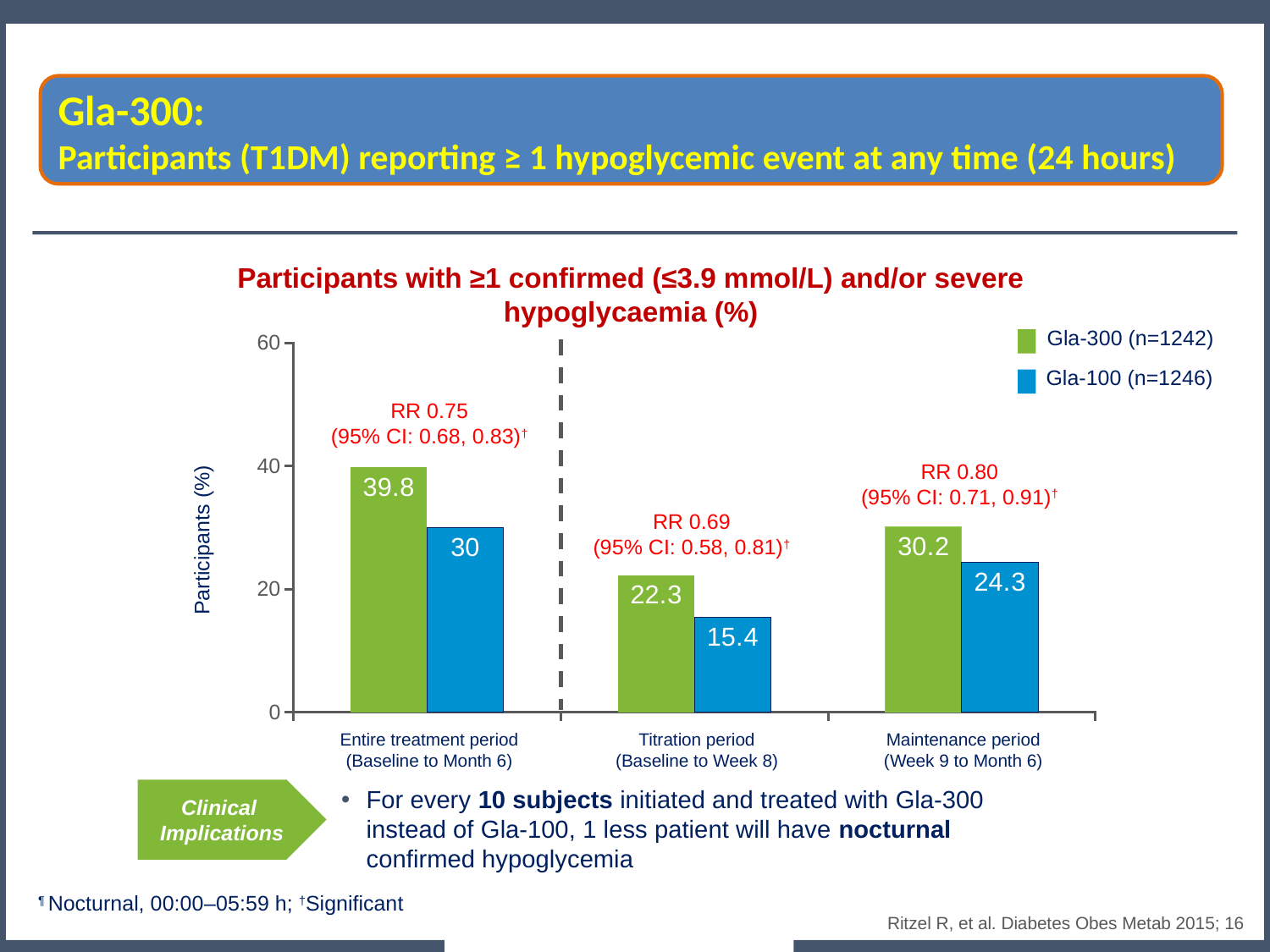
How many series does the legend list? 2 What is the value for Gla-100 in the Maintenance period (Week 9 to Month 6)? 24.3 What is the difference between the Gla-300 and Gla-100 values in the Entire treatment period? 9.8 Which period has the highest value for Gla-300? Entire treatment period (Baseline to Month 6) Is the value for Gla-300 in the Maintenance period greater or less than 40? less Which period has the lowest value for Gla-100? Titration period (Baseline to Week 8) How many periods (categories) are shown on the x axis? 3 What kind of chart is shown on the slide? bar chart In the Maintenance period, which is larger: the Gla-300 value or the Gla-100 value? Gla-300 What is the difference between the Gla-300 and Gla-100 values in the Titration period? 6.9 What is the value for Gla-100 in the Titration period (Baseline to Week 8)? 15.4 What is the value for Gla-300 in the Entire treatment period (Baseline to Month 6)? 39.8